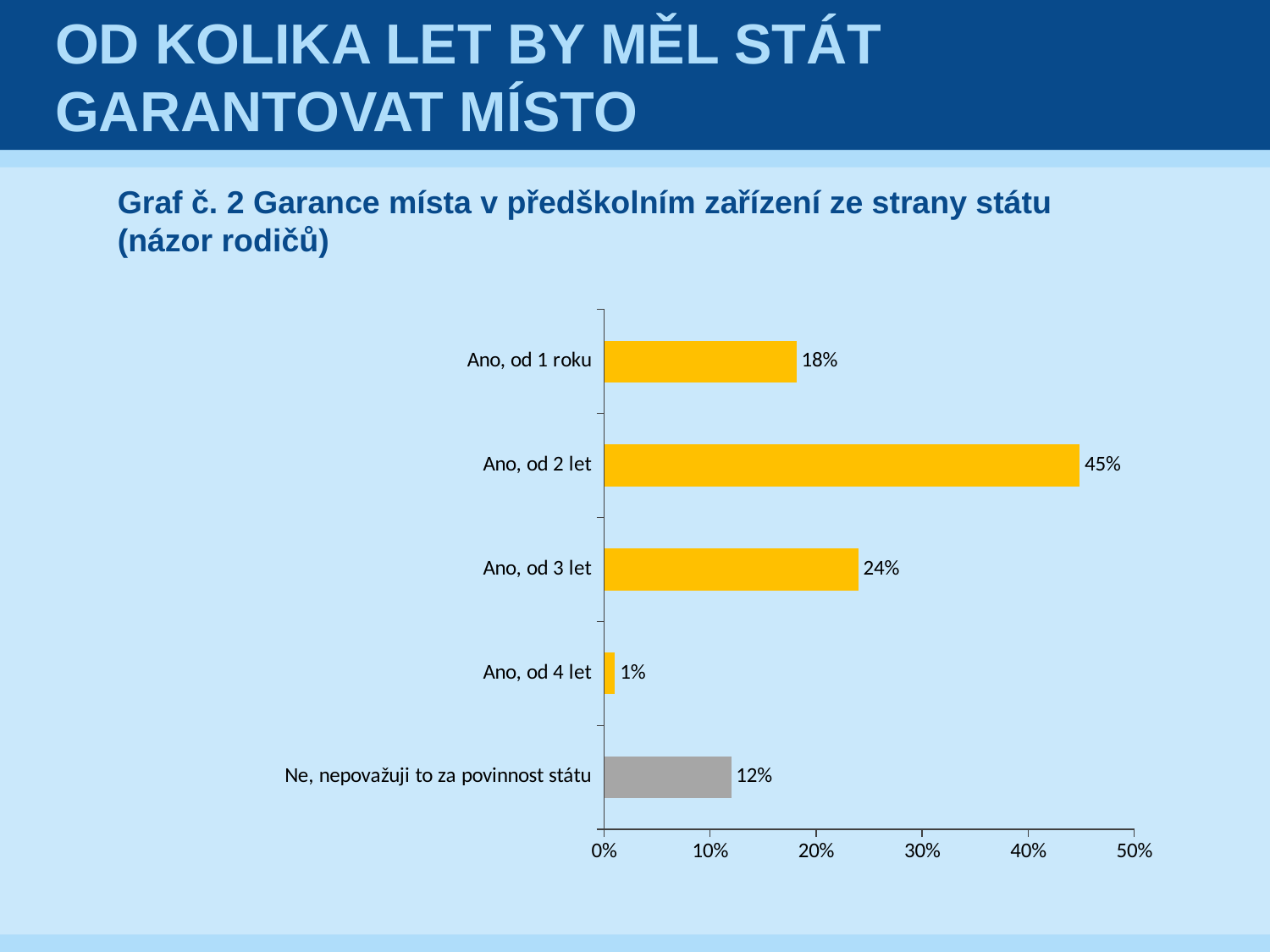
What is the difference between the values for "Ano, od 2 let" and "Ano, od 3 let"? 21% What is the difference between the values for "Ano, od 1 roku" and "Ne, nepovažuji to za povinnost státu"? 6% What is the value for "Ano, od 2 let"? 45% Which is larger, the value for "Ano, od 1 roku" or the value for "Ano, od 3 let"? Ano, od 3 let Which category has the lowest value? Ano, od 4 let Is the value for "Ano, od 2 let" greater or less than 40%? greater What is the value for "Ne, nepovažuji to za povinnost státu"? 12% What kind of chart is shown on the slide? bar chart How many categories are shown in the chart? 5 Which category's bar is coloured grey rather than yellow? Ne, nepovažuji to za povinnost státu Which category has the highest value? Ano, od 2 let What is the value for "Ano, od 1 roku"? 18%